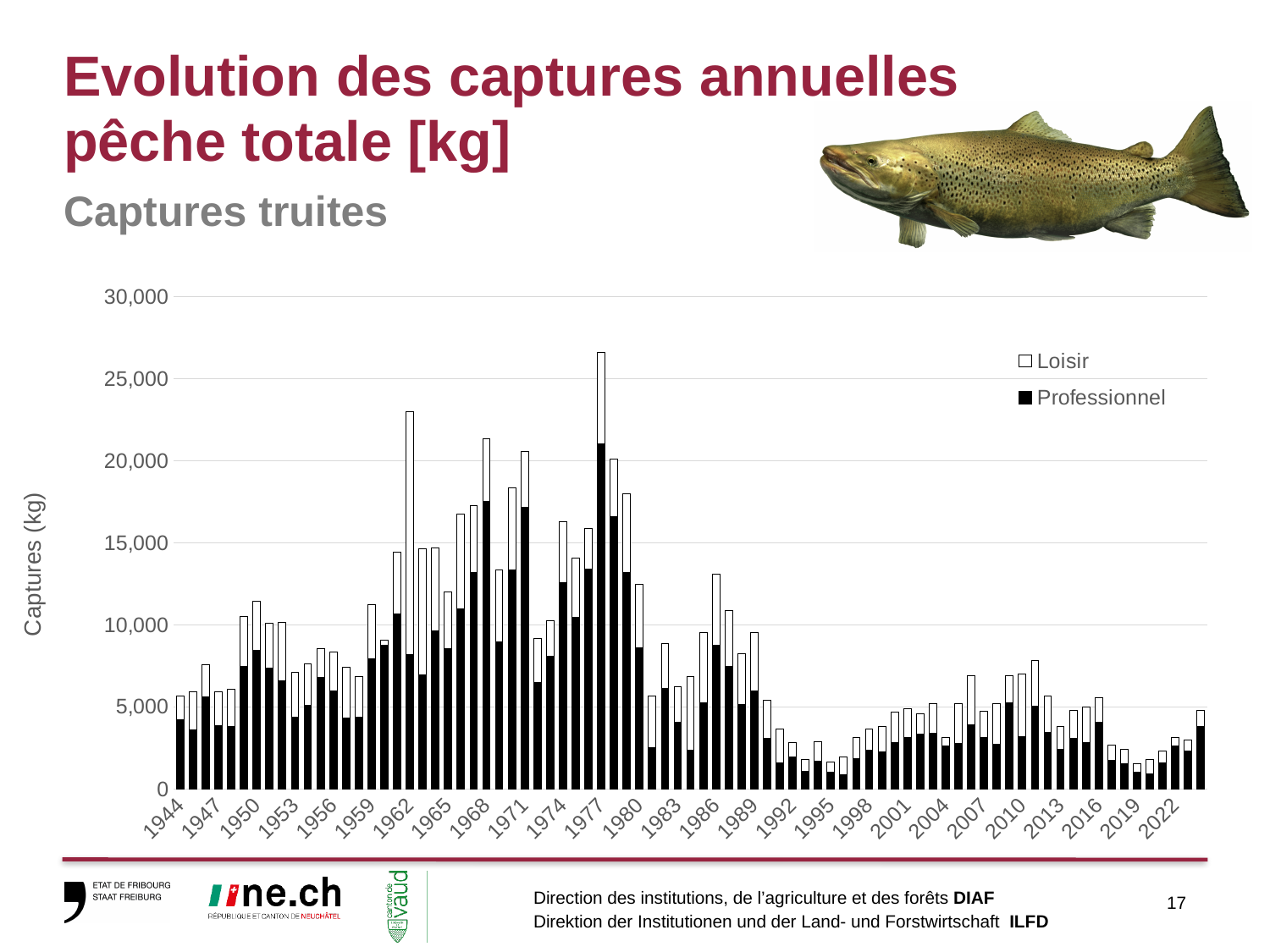
What is the label of the vertical axis? Captures (kg) Is the total catch for 1995 greater or less than 5,000? less Do the total catches generally rise or fall between 1977 and 1995? fall Is the total catch for 2010 greater or less than 10,000? less Is the total catch for 1962 greater or less than 20,000? greater What kind of chart is shown on the slide? Stacked bar chart Which year has the larger total catch, 1962 or 1965? 1962 What are the two series named in the legend? Loisir and Professionnel How many series does the legend list? 2 Which year has the highest total catch? 1977